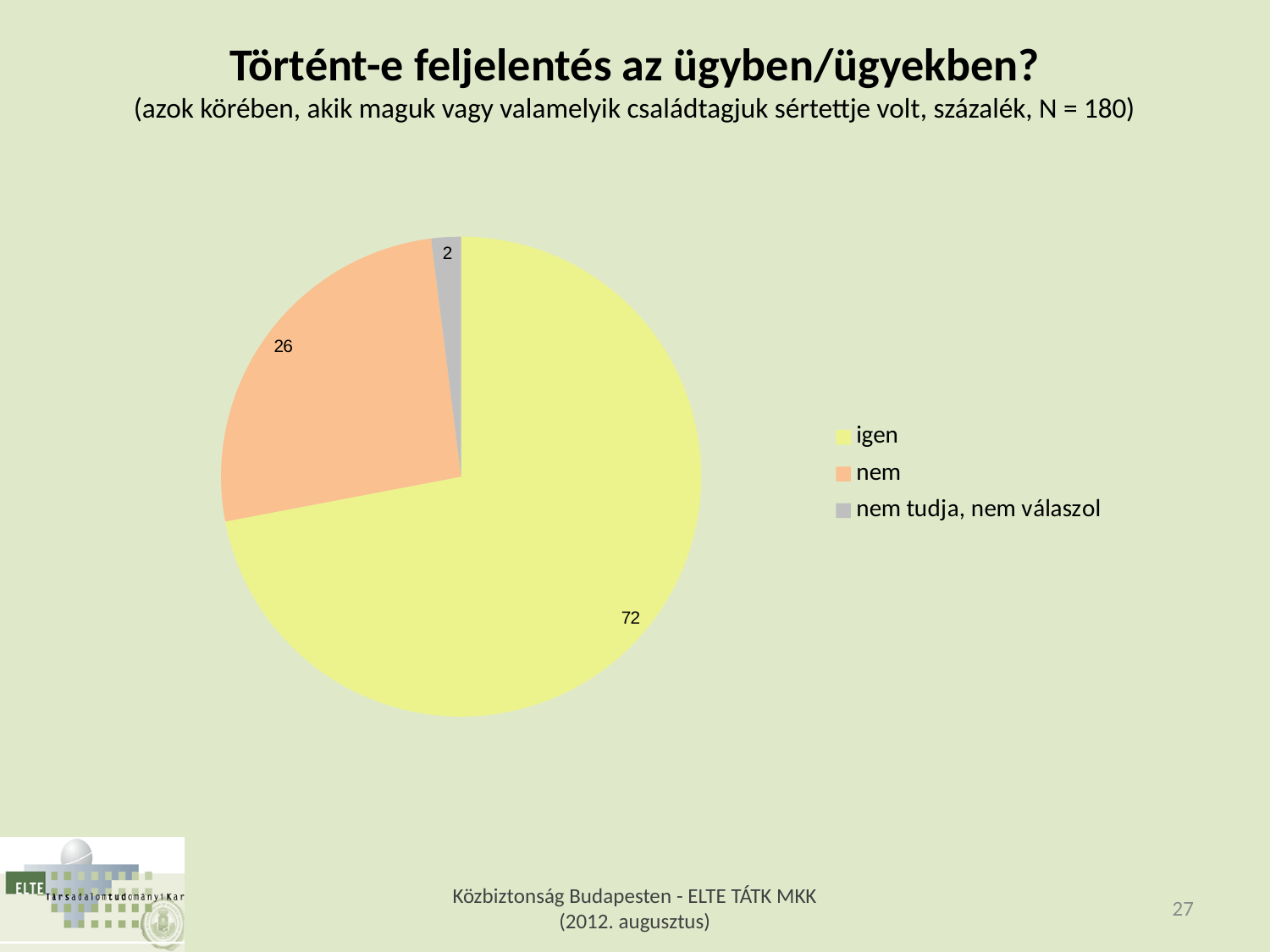
What is the value for "igen"? 72 What is the value for "nem"? 26 What is the title of the chart? Történt-e feljelentés az ügyben/ügyekben? Which category has the smallest slice? nem tudja, nem válaszol What colour is the slice for "nem"? orange What kind of chart is shown on the slide? pie chart What is the value for "nem tudja, nem válaszol"? 2 What is the difference between the values for "igen" and "nem"? 46 How many slices does the pie chart have? 3 How many entries does the legend list? 3 Which category has the largest slice? igen Which is larger, the value for "nem" or the value for "nem tudja, nem válaszol"? nem